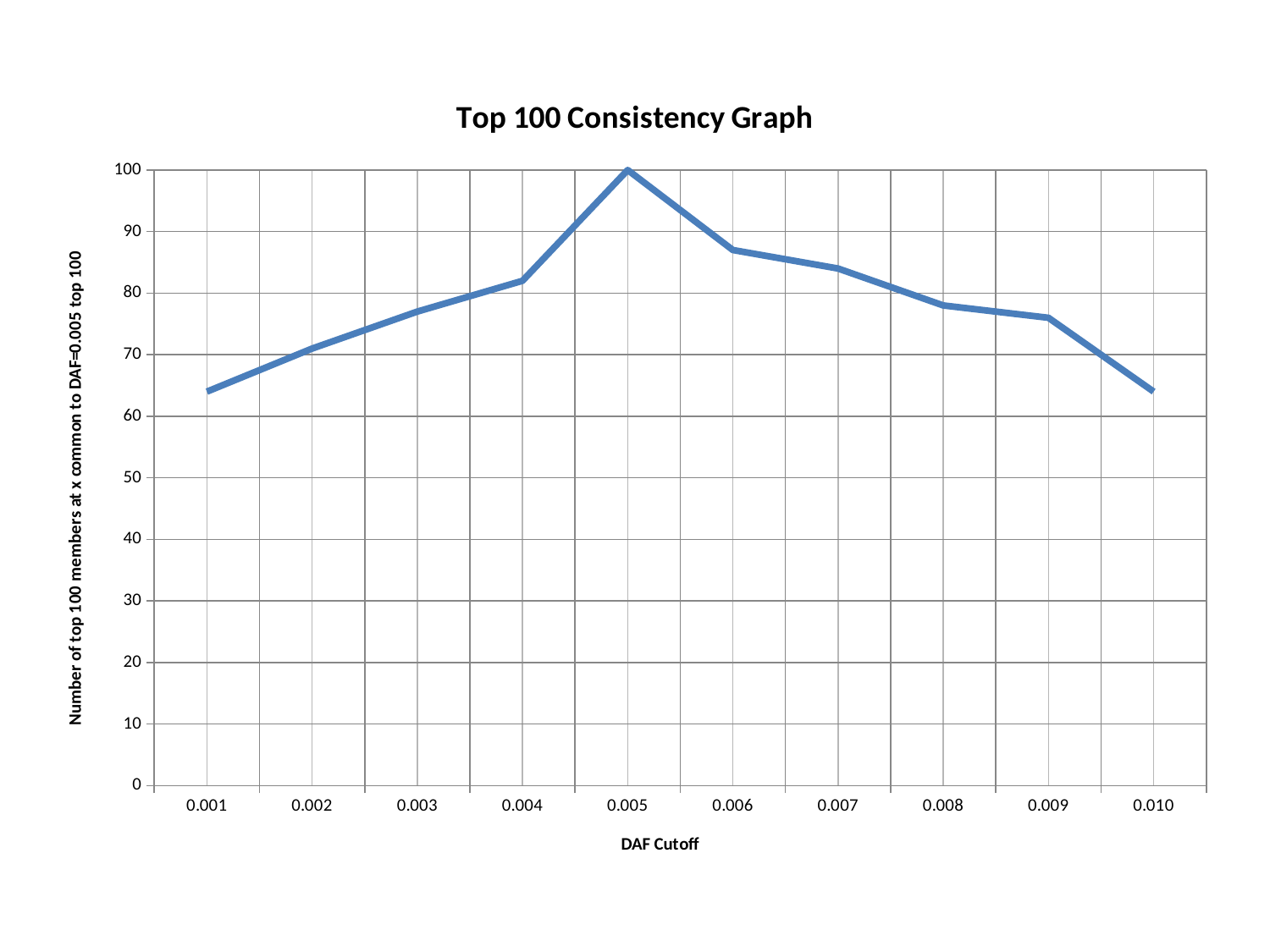
Is the value at a DAF cutoff of 0.010 greater or less than 60? greater What is the value at a DAF cutoff of 0.005? 100 At which DAF cutoff is the number of top 100 members in common highest? 0.005 Is the value at a DAF cutoff of 0.001 greater or less than 70? less Is the value at a DAF cutoff of 0.004 greater or less than 80? greater Which has the larger value, a DAF cutoff of 0.004 or 0.006? 0.006 How many DAF cutoff values are plotted on the x axis? 10 Do the values rise or fall as the DAF cutoff increases from 0.005 to 0.010? fall What kind of chart is shown on the slide? line chart What is the title of the chart? Top 100 Consistency Graph What is the label of the x axis? DAF Cutoff